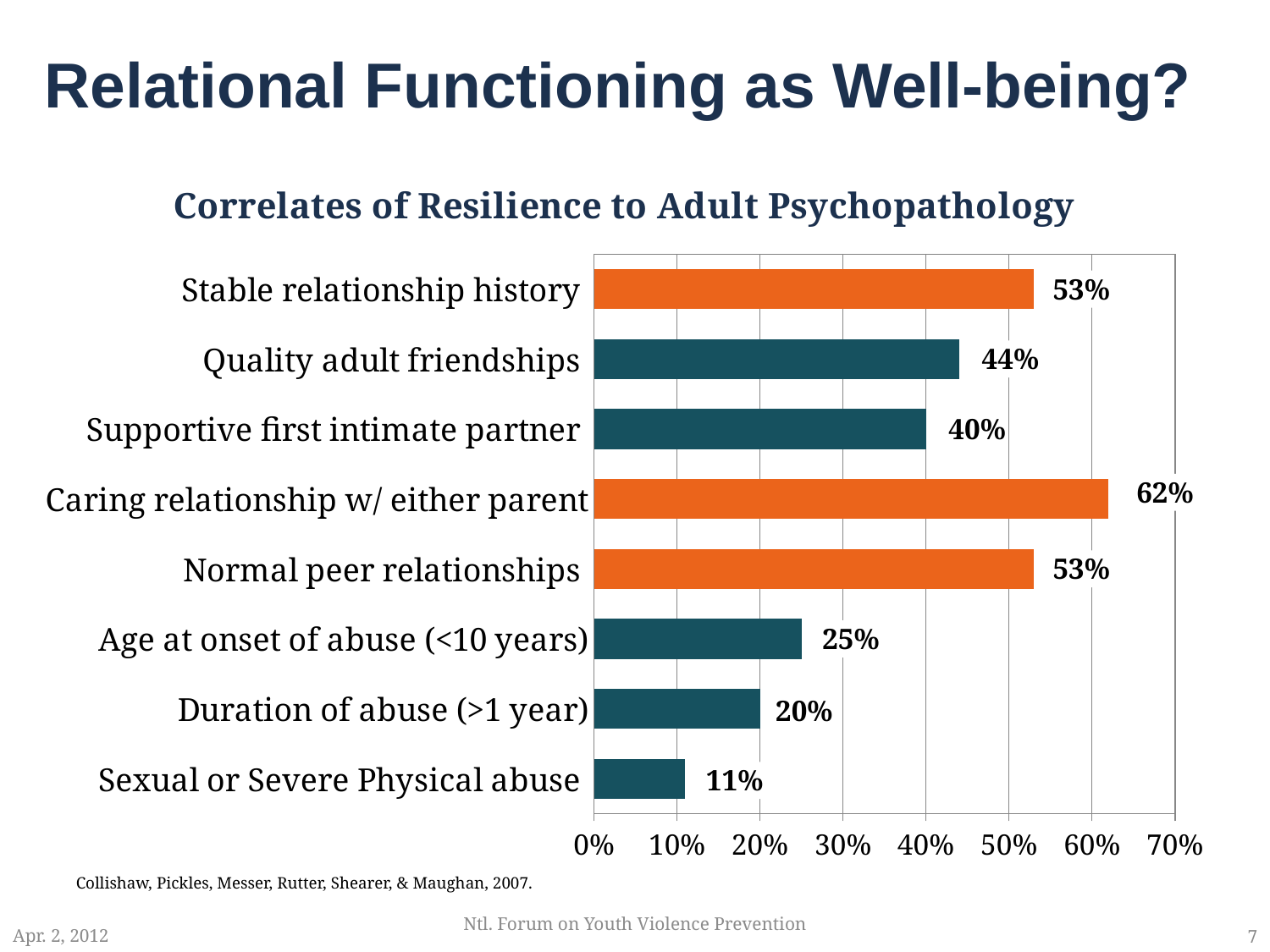
What kind of chart is shown on the slide? bar chart What is the title of the chart? Correlates of Resilience to Adult Psychopathology Is the value for Normal peer relationships greater or less than 50%? greater What is the value for Sexual or Severe Physical abuse? 11% What is the value for Quality adult friendships? 44% Which category has the lowest value? Sexual or Severe Physical abuse How many categories are shown in the chart? 8 What is the difference between the values for Caring relationship w/ either parent and Stable relationship history? 9% Which category has the highest value? Caring relationship w/ either parent What is the value for Caring relationship w/ either parent? 62% Which is larger, the value for Supportive first intimate partner or the value for Age at onset of abuse (<10 years)? Supportive first intimate partner What is the value for Duration of abuse (>1 year)? 20%